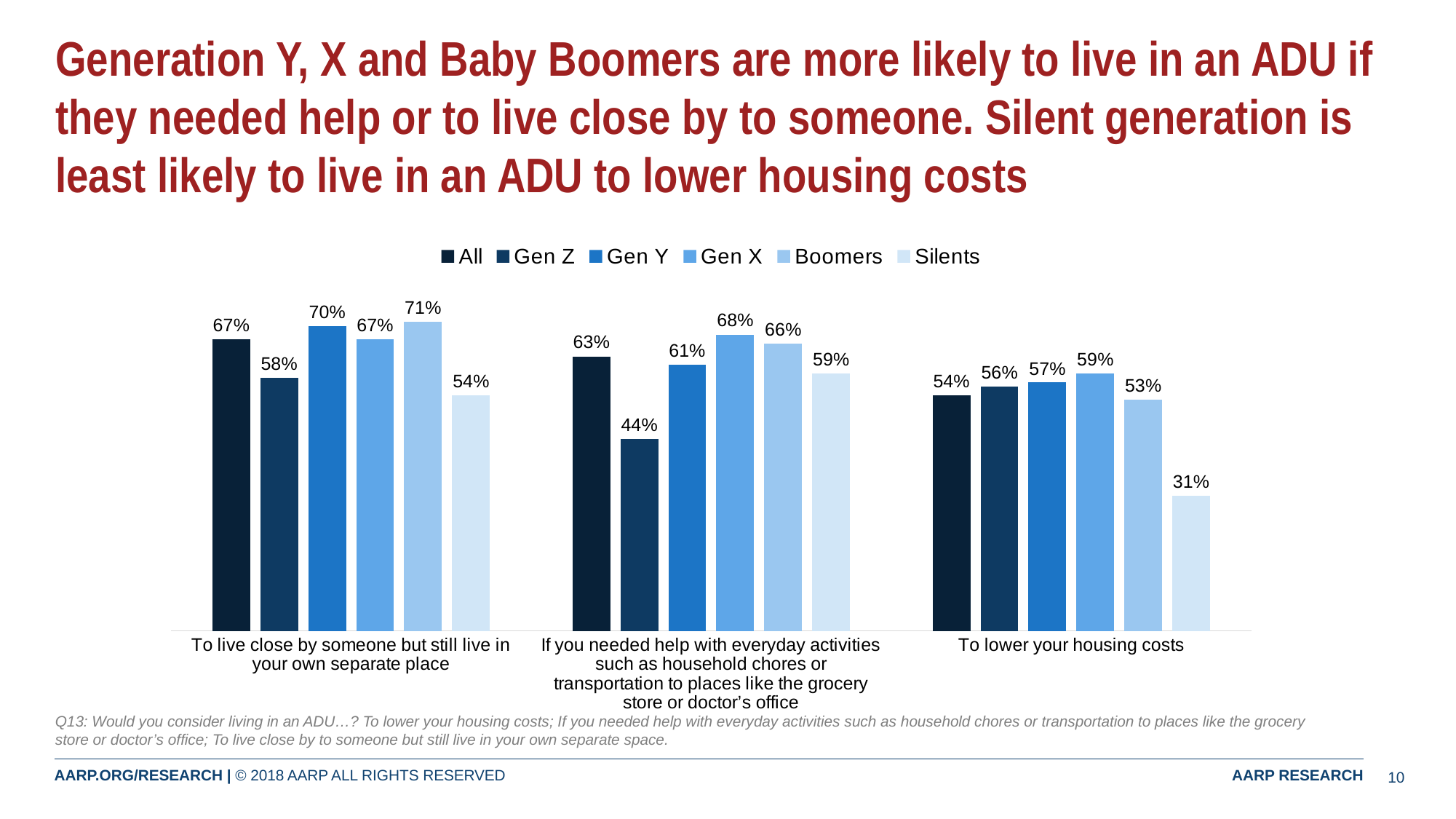
How many series does the legend list? 6 What percentage of Silents would consider living in an ADU to lower their housing costs? 31% What is the value for Boomers in the 'To live close by someone but still live in your own separate place' category? 71% Which generation has the highest value in the 'To lower your housing costs' category? Gen X How many categories are shown on the x axis? 3 What is the value for 'All' in the 'If you needed help with everyday activities' category? 63% Which is larger in the 'To live close by someone' category: the value for Gen Y or the value for Gen Z? Gen Y Which legend entry is shown in the lightest shade of blue? Silents What is the difference between the Gen Y and Silents values in the 'To lower your housing costs' category? 26% What kind of chart is shown on the slide? Bar chart What is the value for Gen Z in the 'If you needed help with everyday activities' category? 44% Which generation has the lowest value in the 'If you needed help with everyday activities' category? Gen Z